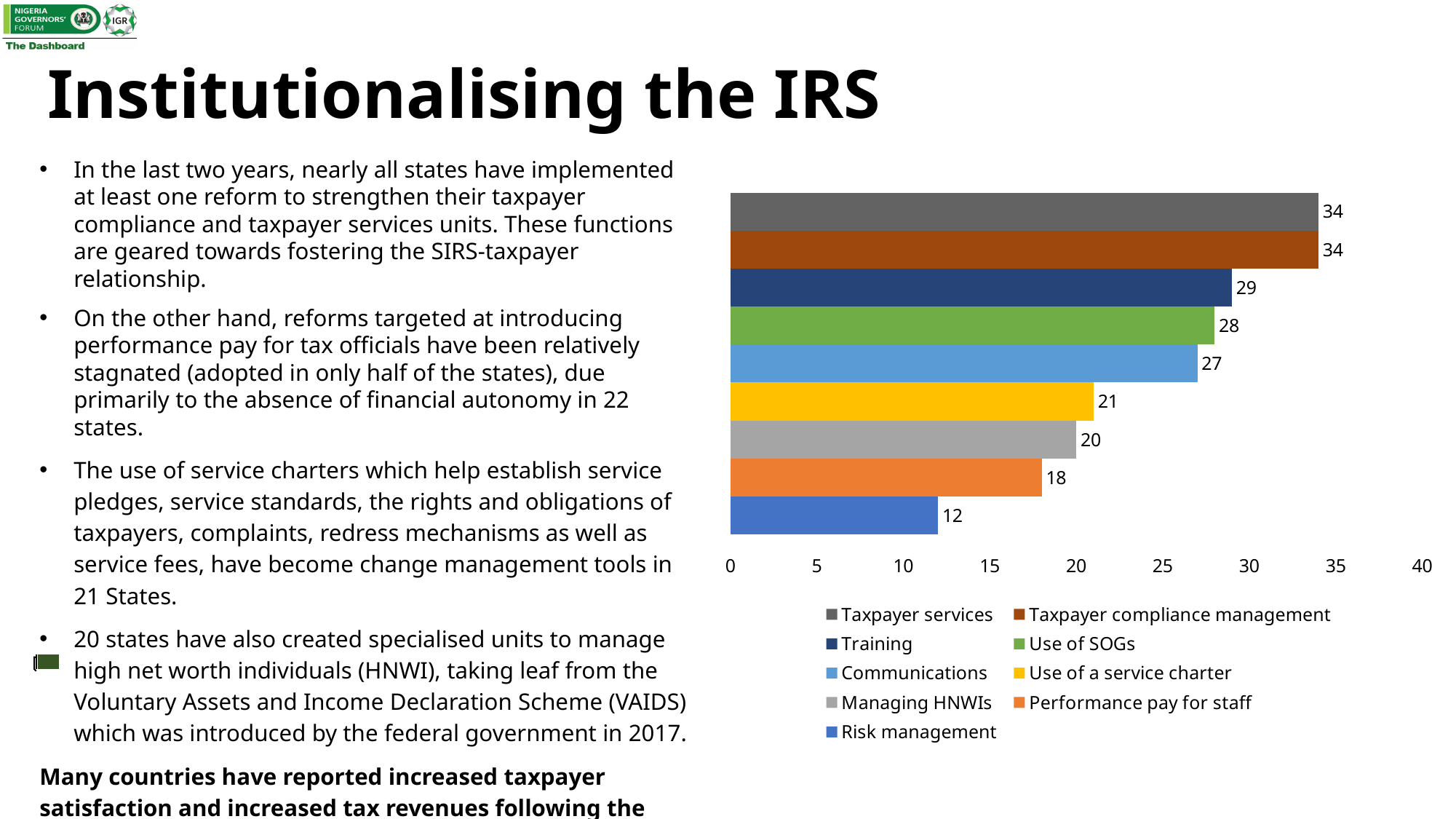
What is the value for Use of a service charter? 21 What is the value for Training? 29 How many bars are plotted in the chart? 9 Which category has the lowest value? Risk management What is the difference between the values for Taxpayer services and Risk management? 22 Which is larger, the value for Use of SOGs or the value for Communications? Use of SOGs What is the value for Performance pay for staff? 18 How many entries does the legend list? 9 What kind of chart is shown on the slide? bar chart What is the value for Managing HNWIs? 20 What is the value for Taxpayer compliance management? 34 Is the value for Communications greater or less than 25? greater